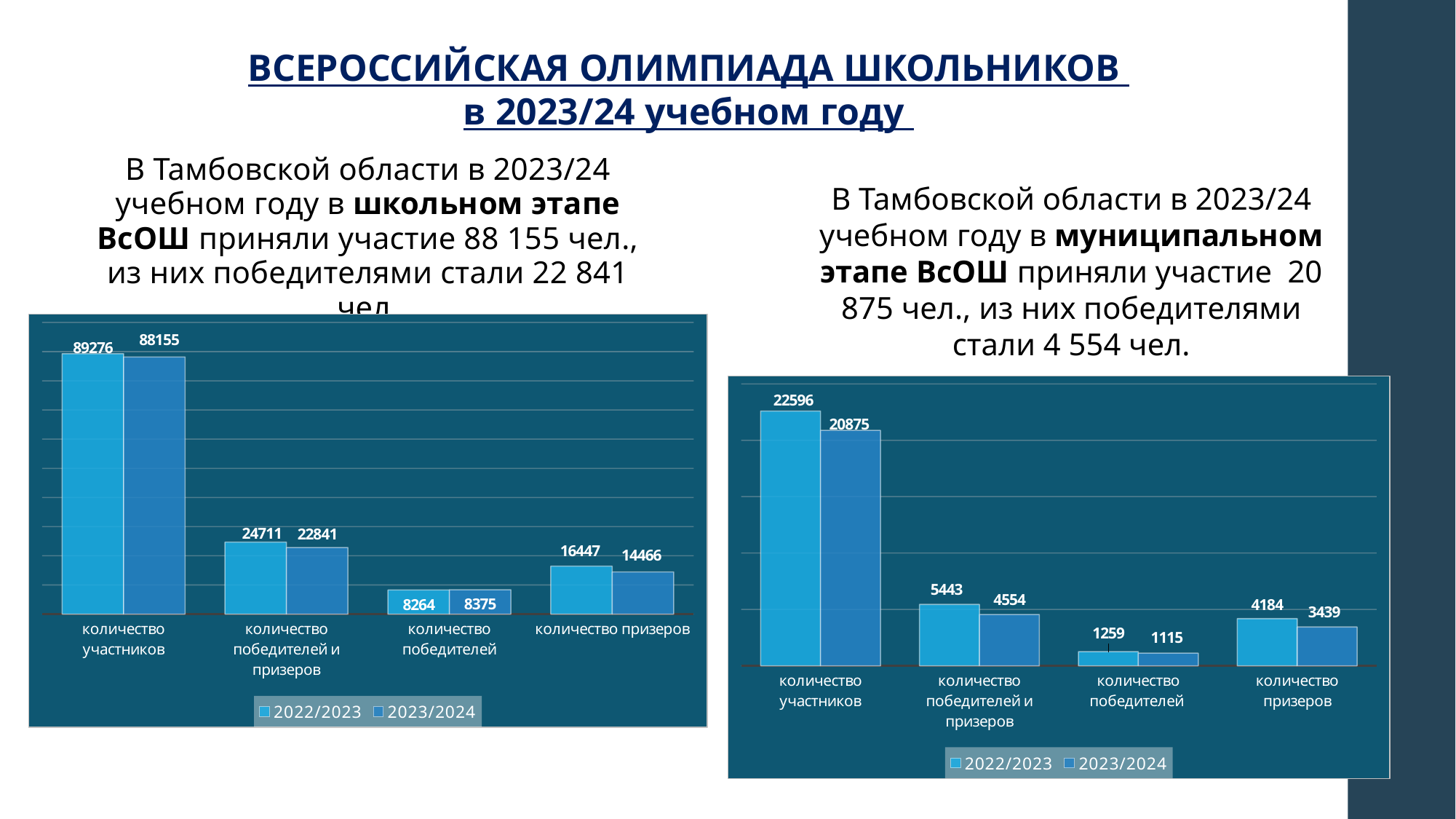
How many categories are shown on the x axis of the right chart? 4 How many series does the legend of the left chart list? 2 In the left chart, for 'количество победителей', which series is larger: 2022/2023 or 2023/2024? 2023/2024 In the left chart, which category has the lowest values? количество победителей In the right chart, which category has the highest values? количество участников In the right chart, what is the value for 'количество победителей и призеров' in the 2022/2023 series? 5443 In the right chart, what is the value for 'количество призеров' in the 2023/2024 series? 3439 What type of chart is the right chart? bar chart In the left chart, what is the value for 'количество победителей' in the 2022/2023 series? 8264 In the right chart, what is the difference between the 2022/2023 and 2023/2024 values for 'количество участников'? 1721 In the left chart, what is the value for 'количество участников' in the 2023/2024 series? 88155 In the left chart, what is the difference between the 2022/2023 and 2023/2024 values for 'количество победителей и призеров'? 1870